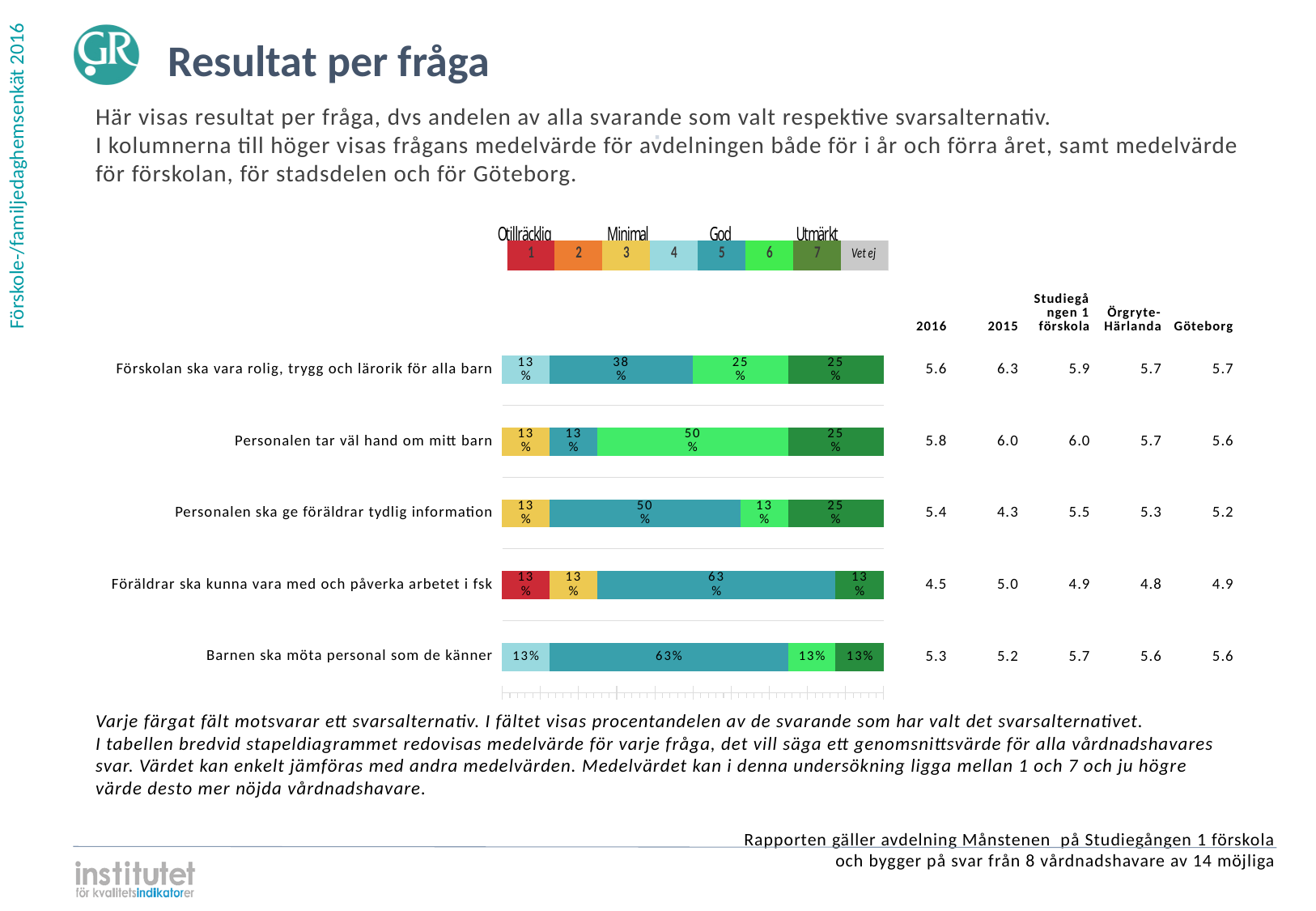
What is the difference between the 2016 and 2015 mean values for 'Personalen ska ge föräldrar tydlig information'? 1.1 How many answer alternatives does the legend above the chart list? 8 What is the 2016 mean value for 'Förskolan ska vara rolig, trygg och lärorik för alla barn'? 5.6 What percentage of respondents chose alternative 5 (teal) for 'Föräldrar ska kunna vara med och påverka arbetet i fsk'? 63% What percentage of respondents chose alternative 6 (bright green) for 'Personalen tar väl hand om mitt barn'? 50% What kind of chart is shown on the slide? Stacked bar chart How many questions (categories) are plotted in the bar chart? 5 What share of respondents chose alternative 7 (Utmärkt) for 'Förskolan ska vara rolig, trygg och lärorik för alla barn'? 25% Which question has a red segment (alternative 1, Otillräcklig) in its bar? Föräldrar ska kunna vara med och påverka arbetet i fsk Which question has the lowest 2016 mean value? Föräldrar ska kunna vara med och påverka arbetet i fsk For 'Förskolan ska vara rolig, trygg och lärorik för alla barn', which is larger: the 2016 mean or the 2015 mean? 2015 Which question has the highest 2016 mean value? Personalen tar väl hand om mitt barn